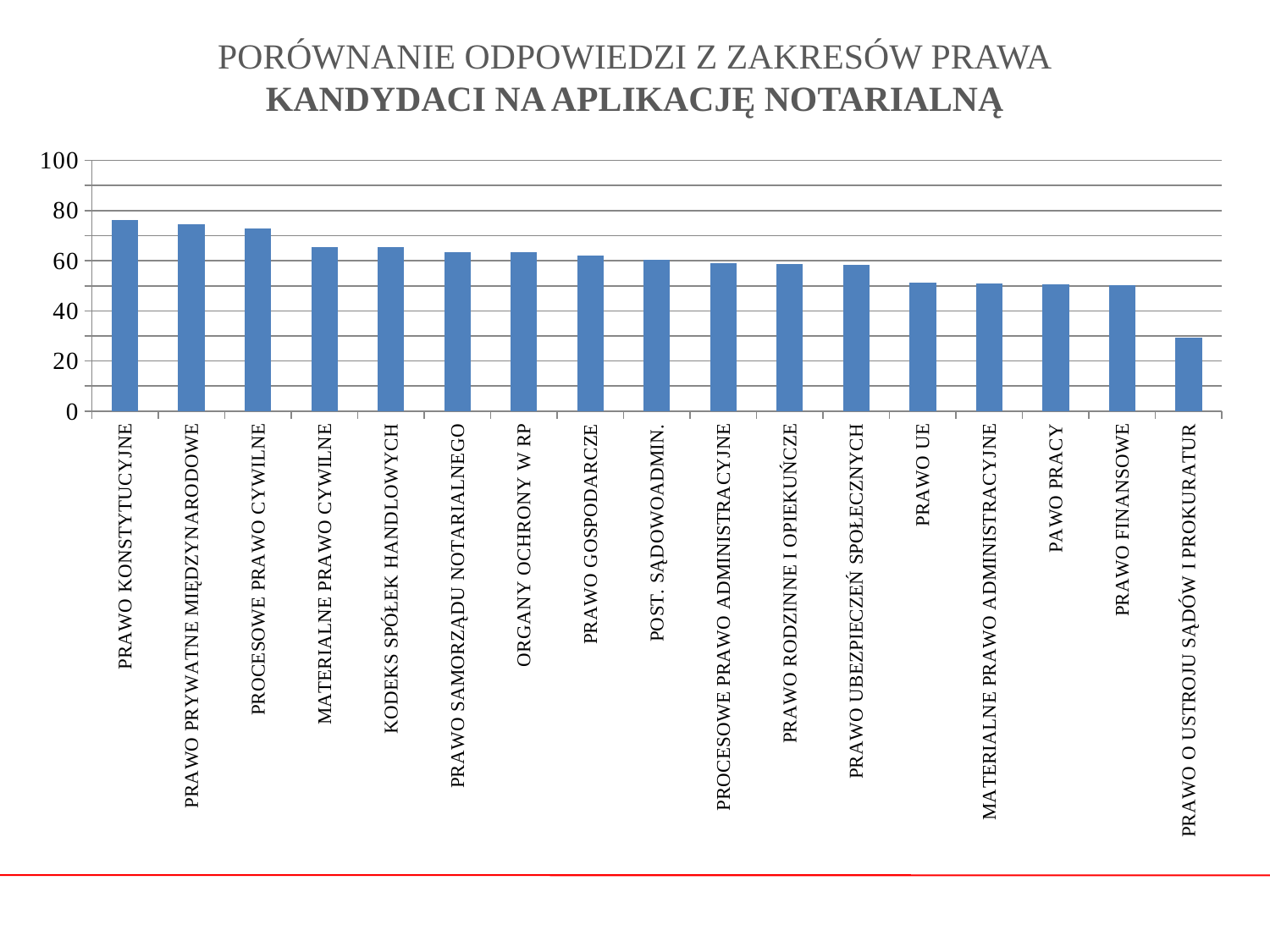
Is the value for PRAWO KONSTYTUCYJNE greater or less than 60? greater How many categories (areas of law) are shown on the chart? 17 Which area of law has the lowest value on the chart? PRAWO O USTROJU SĄDÓW I PROKURATUR Is the value for MATERIALNE PRAWO CYWILNE greater or less than 60? greater Is the value for PRAWO UE greater or less than 40? greater What is the bold second line of the chart title? KANDYDACI NA APLIKACJĘ NOTARIALNĄ What kind of chart is shown on the slide? bar chart Which has a larger value, PRAWO KONSTYTUCYJNE or PRAWO UE? PRAWO KONSTYTUCYJNE Which area of law has the highest value on the chart? PRAWO KONSTYTUCYJNE Do the values generally rise or fall from left to right along the x axis? fall